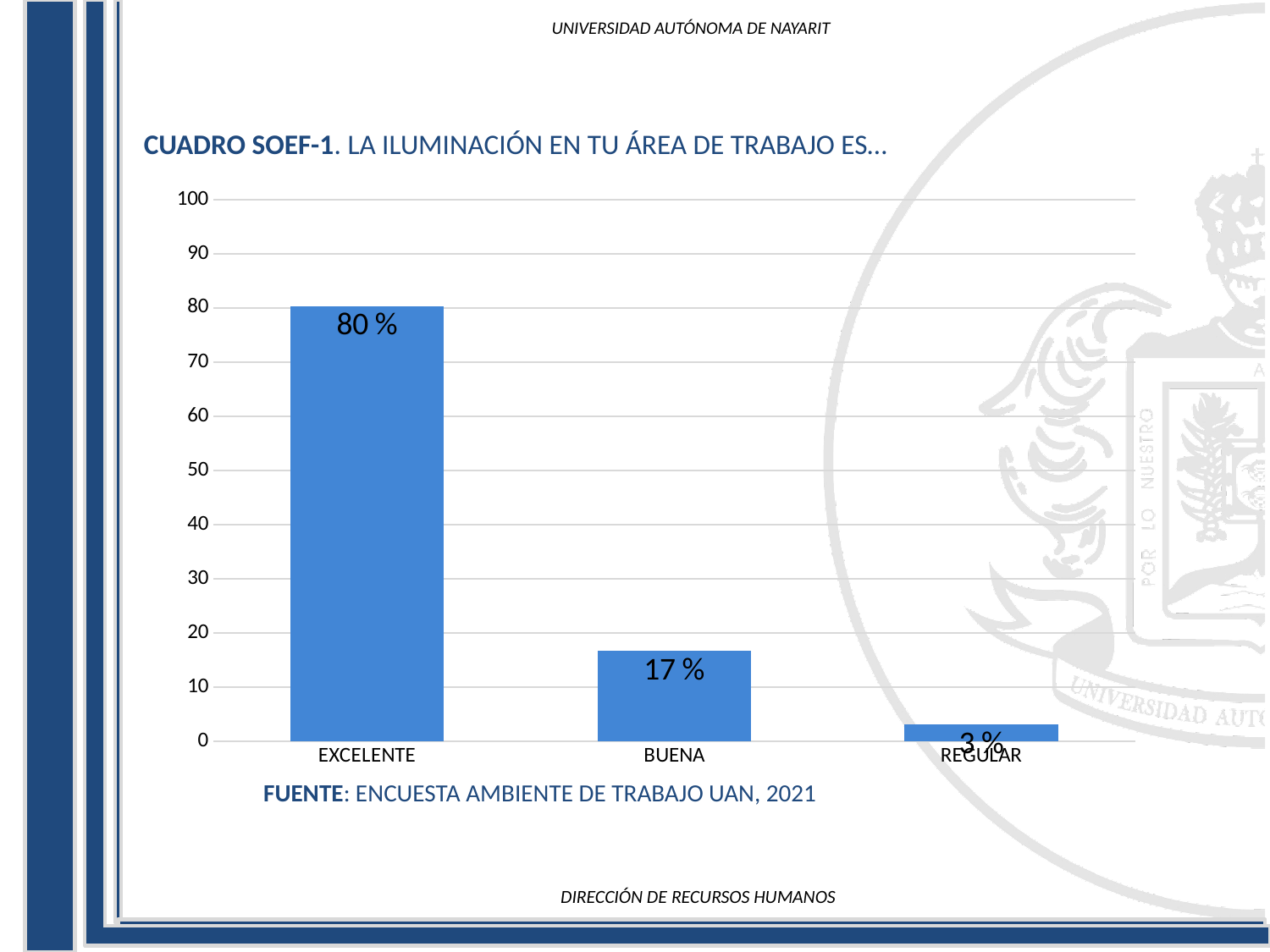
How many categories are shown on the x axis? 3 Which category has the highest value? EXCELENTE What is the value for EXCELENTE? 80 % What kind of chart is shown on the slide? bar chart Is the value for BUENA greater or less than 20? less Which is larger, the value for BUENA or the value for REGULAR? BUENA What is the source cited below the chart? ENCUESTA AMBIENTE DE TRABAJO UAN, 2021 What is the difference between the values for BUENA and REGULAR? 14 % What is the value for REGULAR? 3 % Which category has the lowest value? REGULAR What is the difference between the values for EXCELENTE and BUENA? 63 % What is the value for BUENA? 17 %